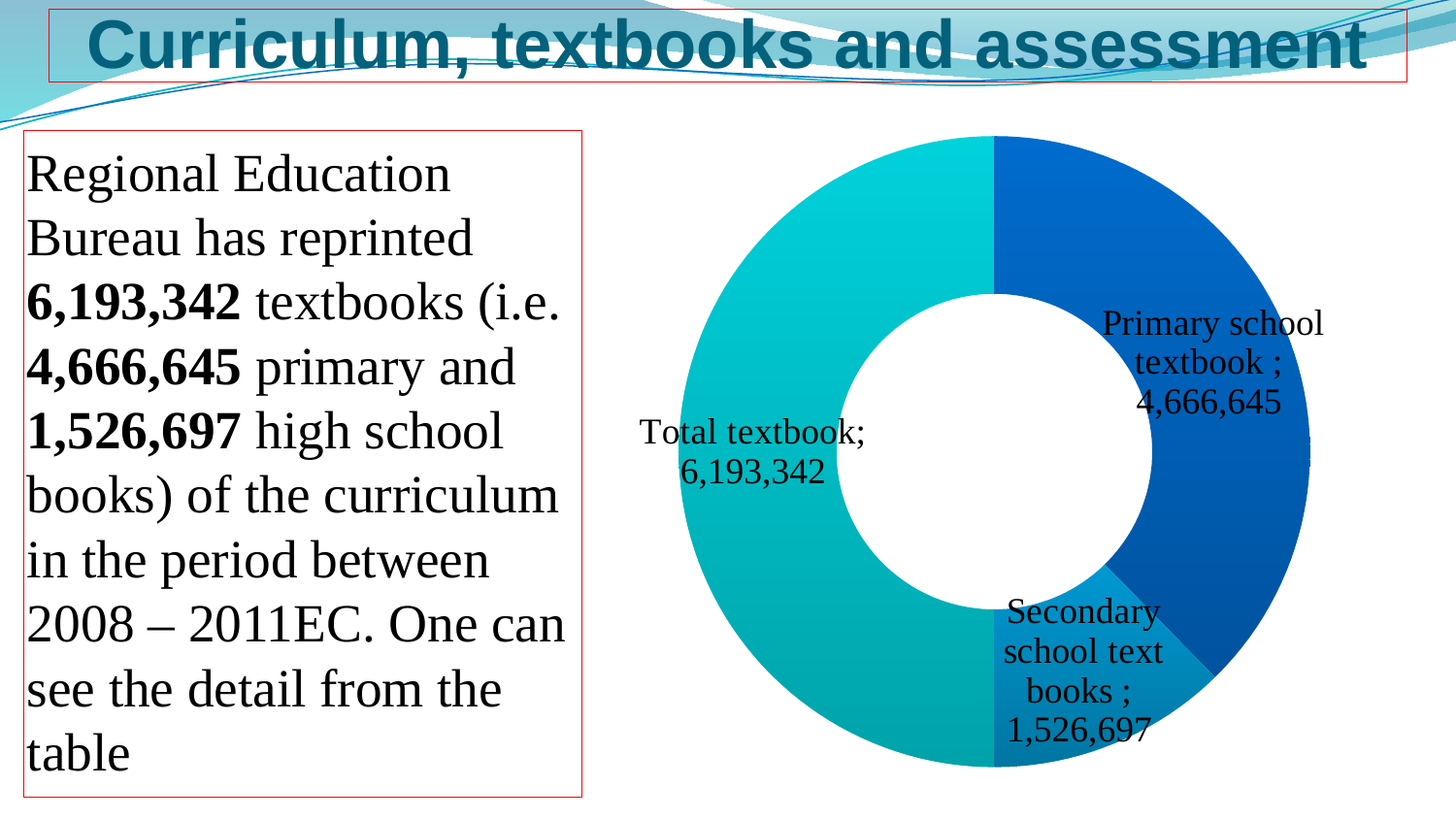
What is the value shown for Secondary school text books? 1,526,697 Which is larger, the value for Primary school textbook or for Secondary school text books? Primary school textbook What is the difference between the Total textbook value and the Primary school textbook value? 1,526,697 What kind of chart is shown on the slide? doughnut chart Which slice of the chart is drawn in the lightest teal colour? Total textbook Which slice of the chart has the smallest value? Secondary school text books What is the value shown for Total textbook? 6,193,342 What is the value shown for Primary school textbook? 4,666,645 Which slice of the chart has the largest value? Total textbook How many slices does the doughnut chart have? 3 What is the title of the slide containing the chart? Curriculum, textbooks and assessment What is the difference between the Primary school textbook value and the Secondary school text books value? 3,139,948